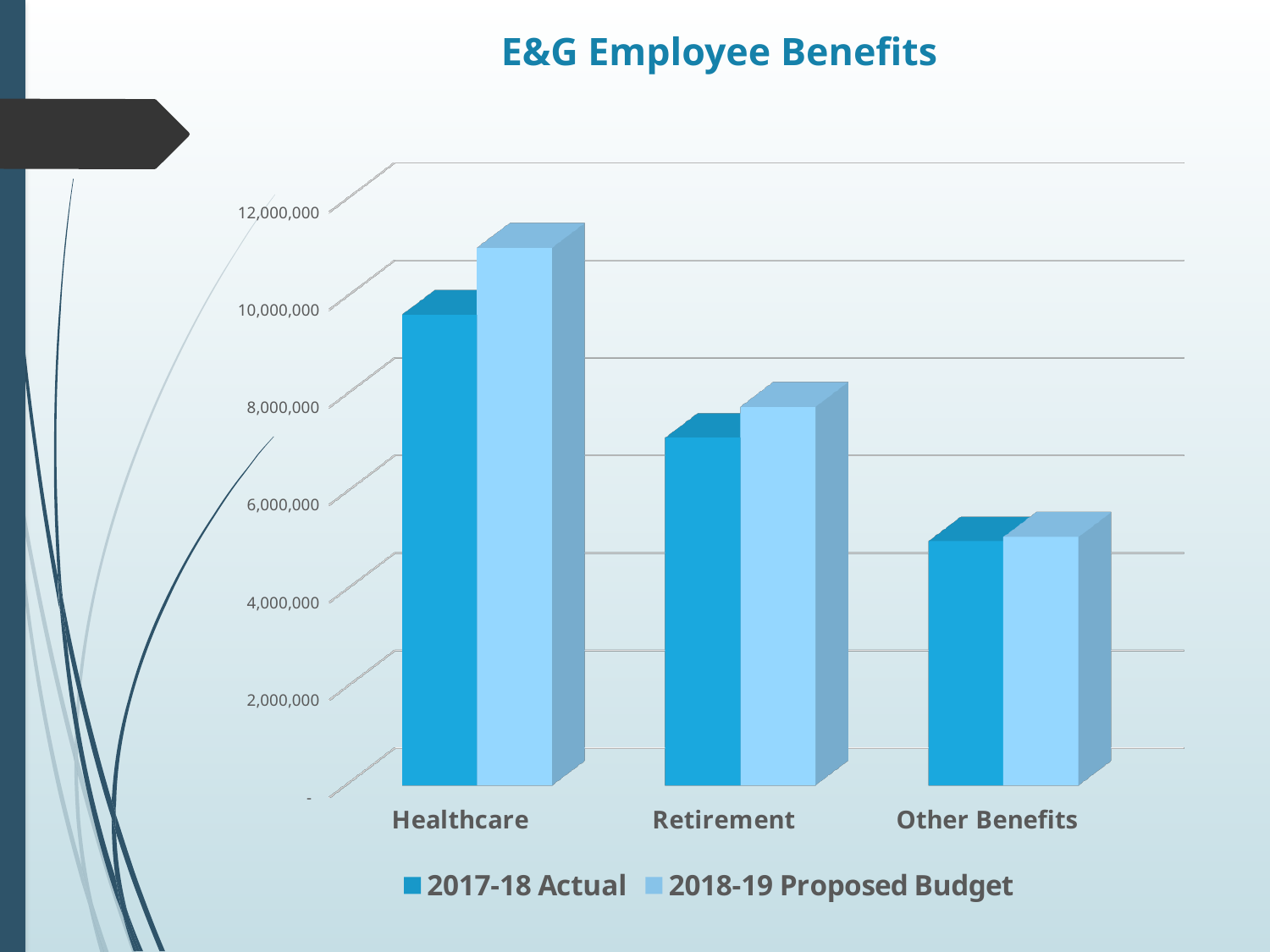
Which category has the highest value for the 2018-19 Proposed Budget series? Healthcare Is the 2017-18 Actual value for Other Benefits greater or less than 4,000,000? greater Is the 2017-18 Actual value for Retirement greater or less than 8,000,000? less How many categories are shown on the x axis? 3 What kind of chart is shown on the slide? Bar chart For Retirement, which is larger: 2017-18 Actual or 2018-19 Proposed Budget? 2018-19 Proposed Budget How many series does the legend list? 2 Do the 2017-18 Actual values rise or fall moving from Healthcare to Other Benefits along the x axis? fall What is the title of the chart? E&G Employee Benefits Is the 2018-19 Proposed Budget value for Healthcare greater or less than 10,000,000? greater Which category has the lowest value for the 2017-18 Actual series? Other Benefits For Healthcare, which is larger: 2017-18 Actual or 2018-19 Proposed Budget? 2018-19 Proposed Budget